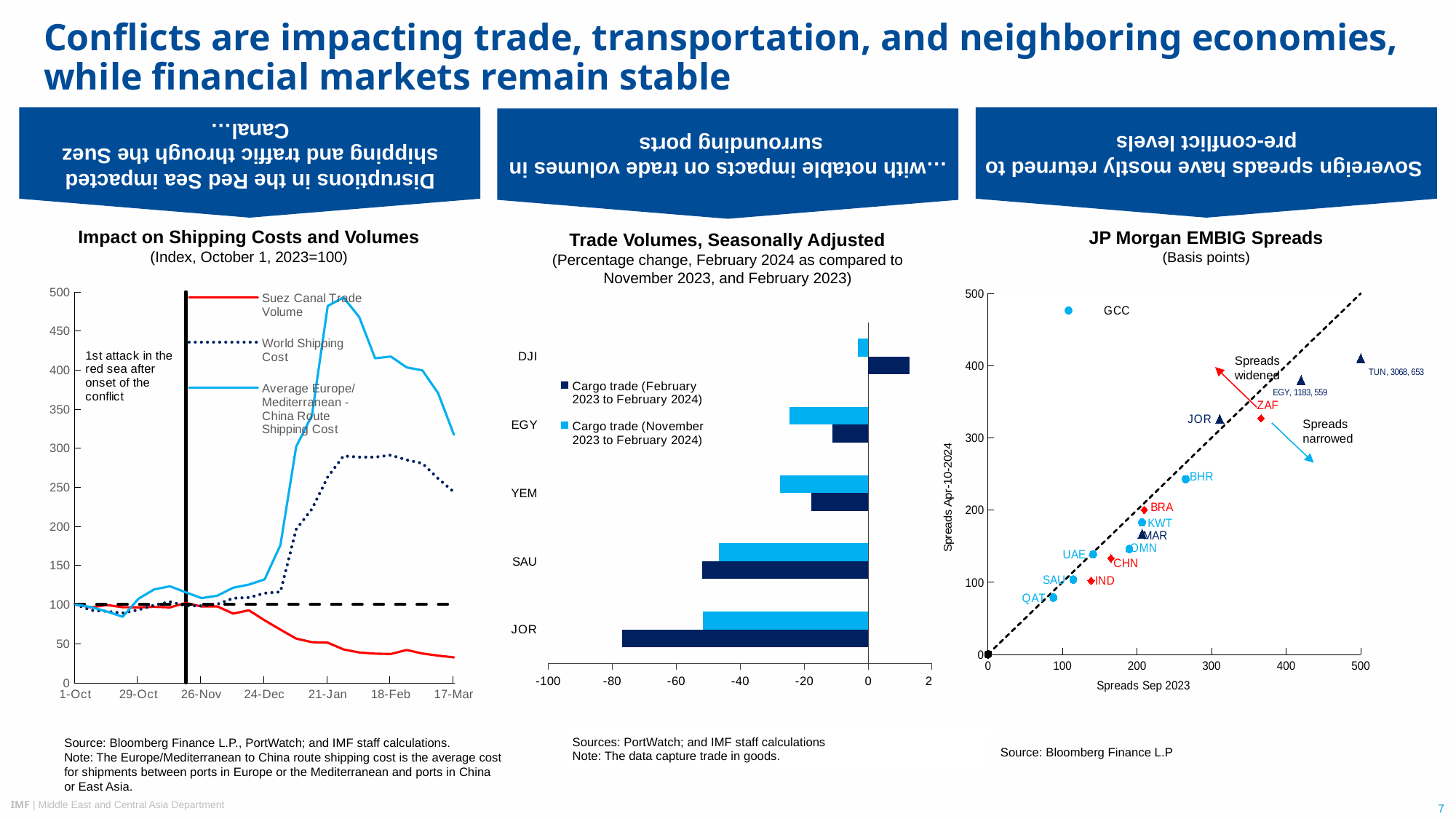
In the 'Impact on Shipping Costs and Volumes' chart, does the Suez Canal Trade Volume line rise or fall from 1-Oct to 17-Mar? fall In the 'Trade Volumes, Seasonally Adjusted' chart, how many series does the legend list? 2 In the 'Impact on Shipping Costs and Volumes' chart, how many series does the legend list? 3 In the 'JP Morgan EMBIG Spreads' chart, what values are printed in the data label for TUN? 3068, 653 What kind of chart is the 'Trade Volumes, Seasonally Adjusted' chart? bar chart In the 'Impact on Shipping Costs and Volumes' chart, is the peak of the Average Europe/Mediterranean - China Route Shipping Cost line greater or less than 450? greater In the 'Impact on Shipping Costs and Volumes' chart, is the Suez Canal Trade Volume value at 17-Mar greater or less than 50? less What kind of chart is the 'JP Morgan EMBIG Spreads' chart? scatter plot In the 'Trade Volumes, Seasonally Adjusted' chart, how many countries are shown on the vertical axis? 5 In the 'Trade Volumes, Seasonally Adjusted' chart, is the Cargo trade (February 2023 to February 2024) value for JOR greater or less than -60? less What kind of chart is the 'Impact on Shipping Costs and Volumes' chart? line chart In the 'Trade Volumes, Seasonally Adjusted' chart, which country has the largest decline in Cargo trade (February 2023 to February 2024)? JOR